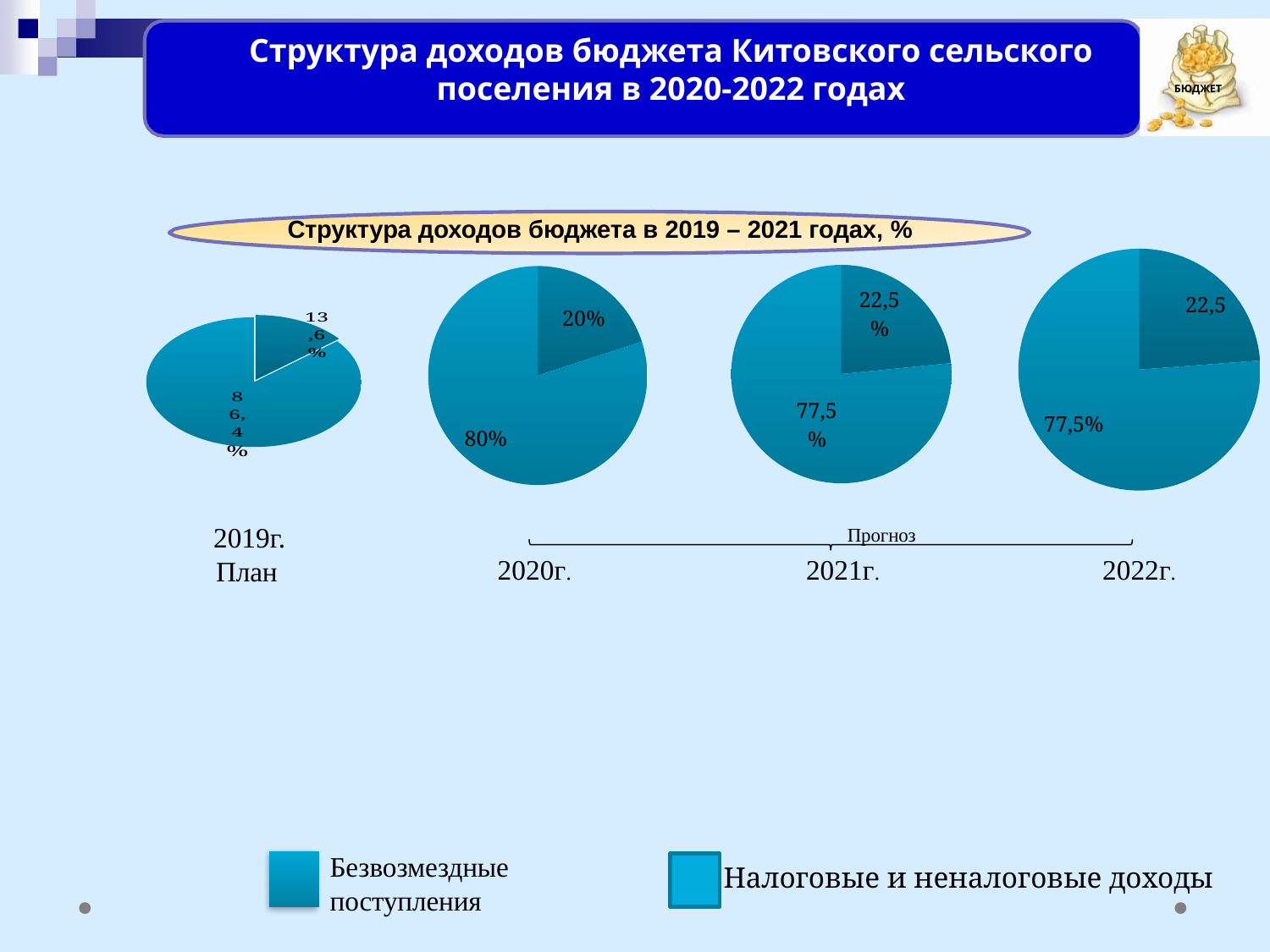
What kind of charts are shown on the slide? Pie charts In the 2019г. План pie chart, what is the value of the larger slice? 86,4% How many entries does the legend at the bottom of the slide list? 2 How many pie charts are shown on the slide? 4 In the 2020г. pie chart, what is the value of the smaller slice? 20% In the 2021г. pie chart, what is the value of the larger slice? 77,5% Which pie chart has the smallest minor slice: 2019г. План or 2020г.? 2019г. План In the 2019г. План pie chart, what is the value of the smaller slice? 13,6% Does the share of the smaller slice rise or fall from the 2019г. План chart to the 2021г. chart? Rise In the 2022г. pie chart, what value is printed on the smaller slice? 22,5 In the 2020г. pie chart, what is the difference in percentage points between the larger and smaller slices? 60 In the 2020г. pie chart, what is the value of the larger slice? 80%